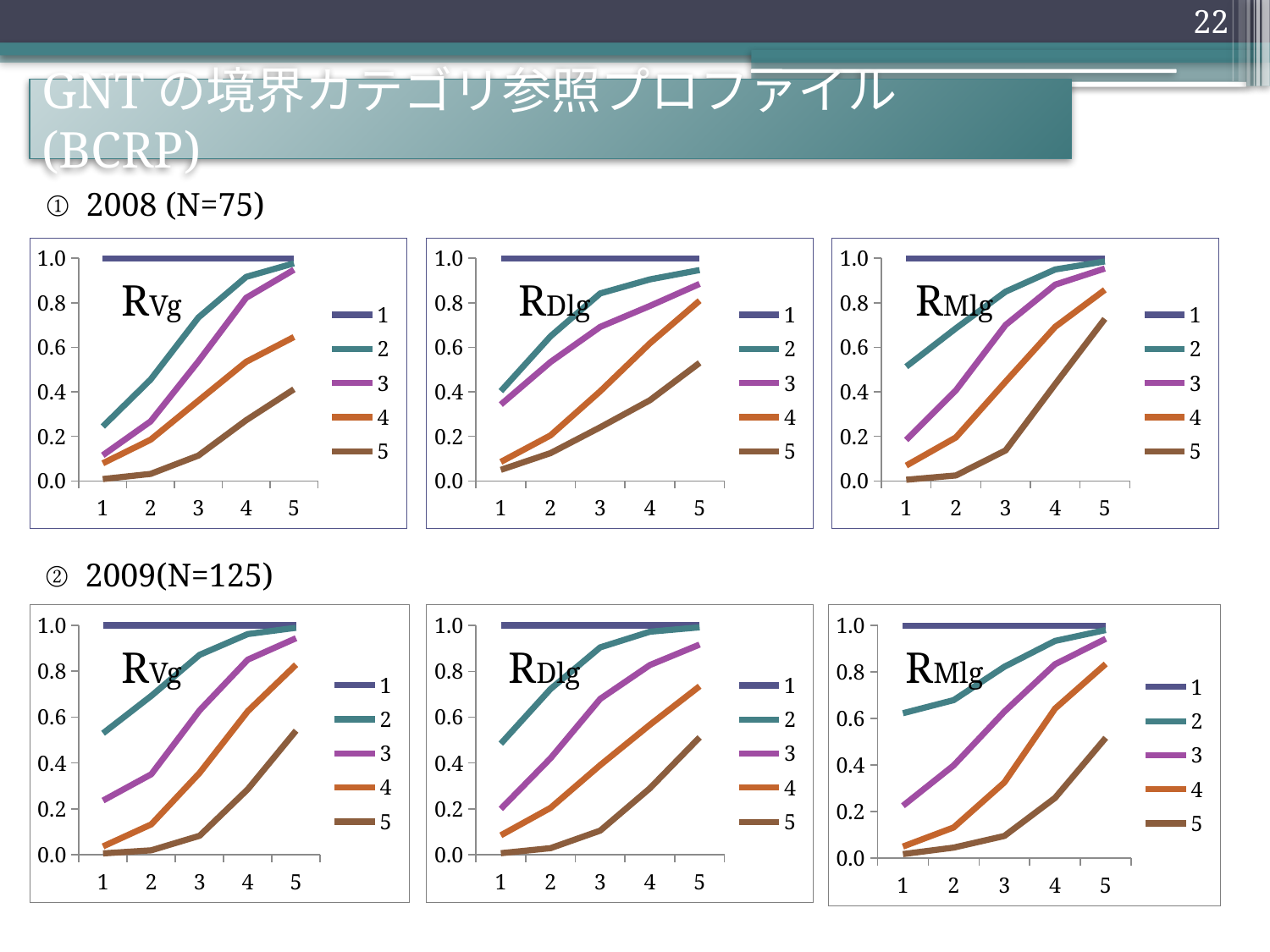
In the 2008 RMlg chart (top right), which series has the lowest value at x = 5? 5 In the 2008 RDlg chart (top middle), how many series does the legend list? 5 In the 2009 RMlg chart (bottom right), how many points are on the x axis? 5 In the 2008 RVg chart (top left), is the value of series 4 at x = 5 greater or less than 0.6? greater In the 2008 RVg chart (top left), at x = 3, which is larger: series 2 or series 5? series 2 In the 2008 RVg chart (top left), what kind of chart is shown? line chart In the 2009 RDlg chart (bottom middle), is the value of series 4 at x = 5 greater or less than 0.6? greater In the 2009 RVg chart (bottom left), is the value of series 2 at x = 1 greater or less than 0.4? greater How many charts are shown on the slide in total? 6 In the 2008 RVg chart (top left), what is the value of series 1 at x = 3? 1.0 In the 2009 RDlg chart (bottom middle), does series 3 rise or fall as x goes from 1 to 5? rise